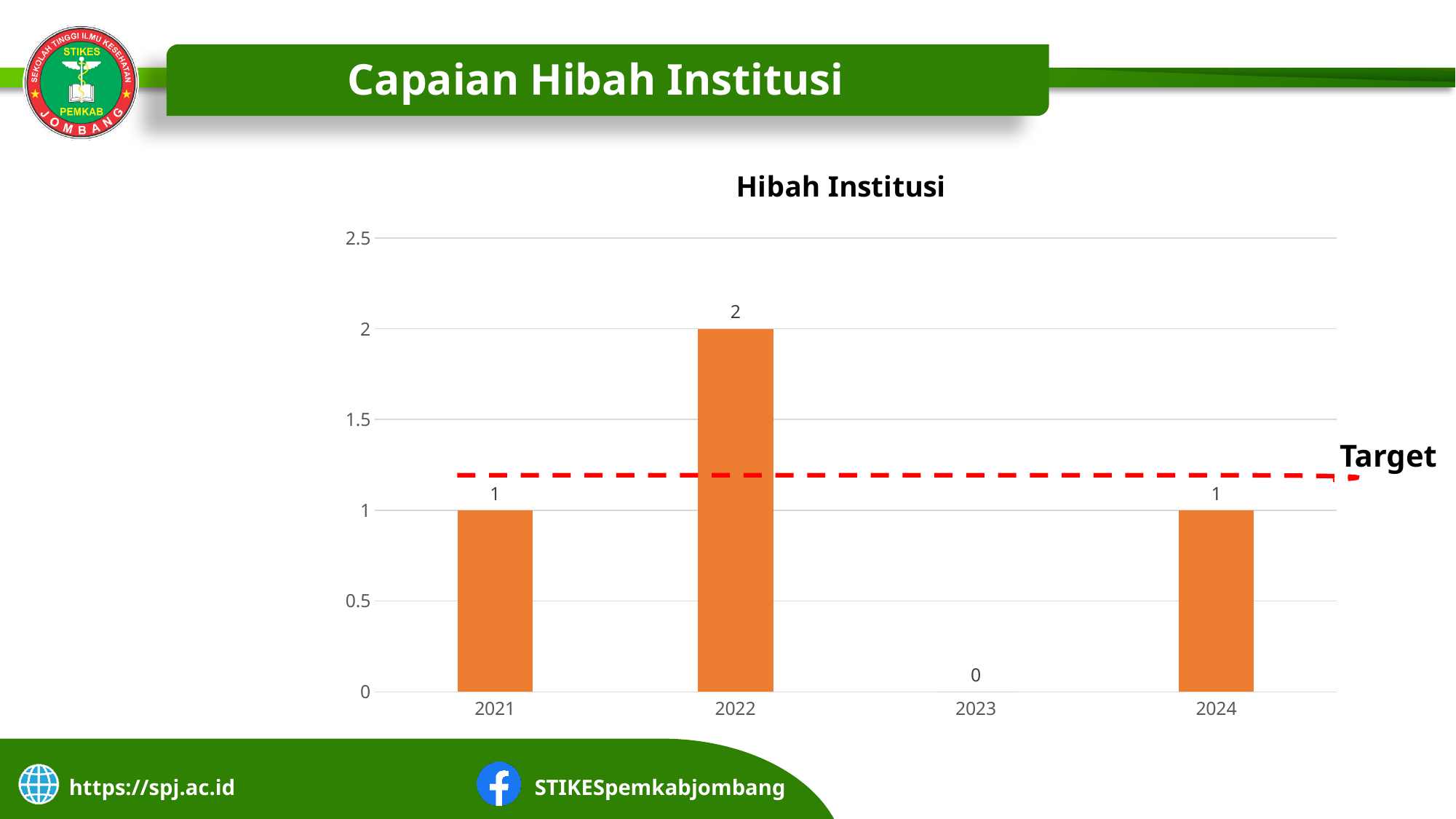
How many years are shown on the x axis of the Hibah Institusi chart? 4 What is the value for 2021 in the Hibah Institusi chart? 1 What is the difference between the values for 2022 and 2024 in the Hibah Institusi chart? 1 Which year has the highest value in the Hibah Institusi chart? 2022 What is the value for 2023 in the Hibah Institusi chart? 0 Which is larger in the Hibah Institusi chart, the value for 2022 or the value for 2021? 2022 What kind of chart is the Hibah Institusi chart? bar chart What is the value for 2022 in the Hibah Institusi chart? 2 What does the red dashed line on the Hibah Institusi chart represent? Target Which year has the lowest value in the Hibah Institusi chart? 2023 What is the value for 2024 in the Hibah Institusi chart? 1 What is the title of the chart on the slide? Hibah Institusi